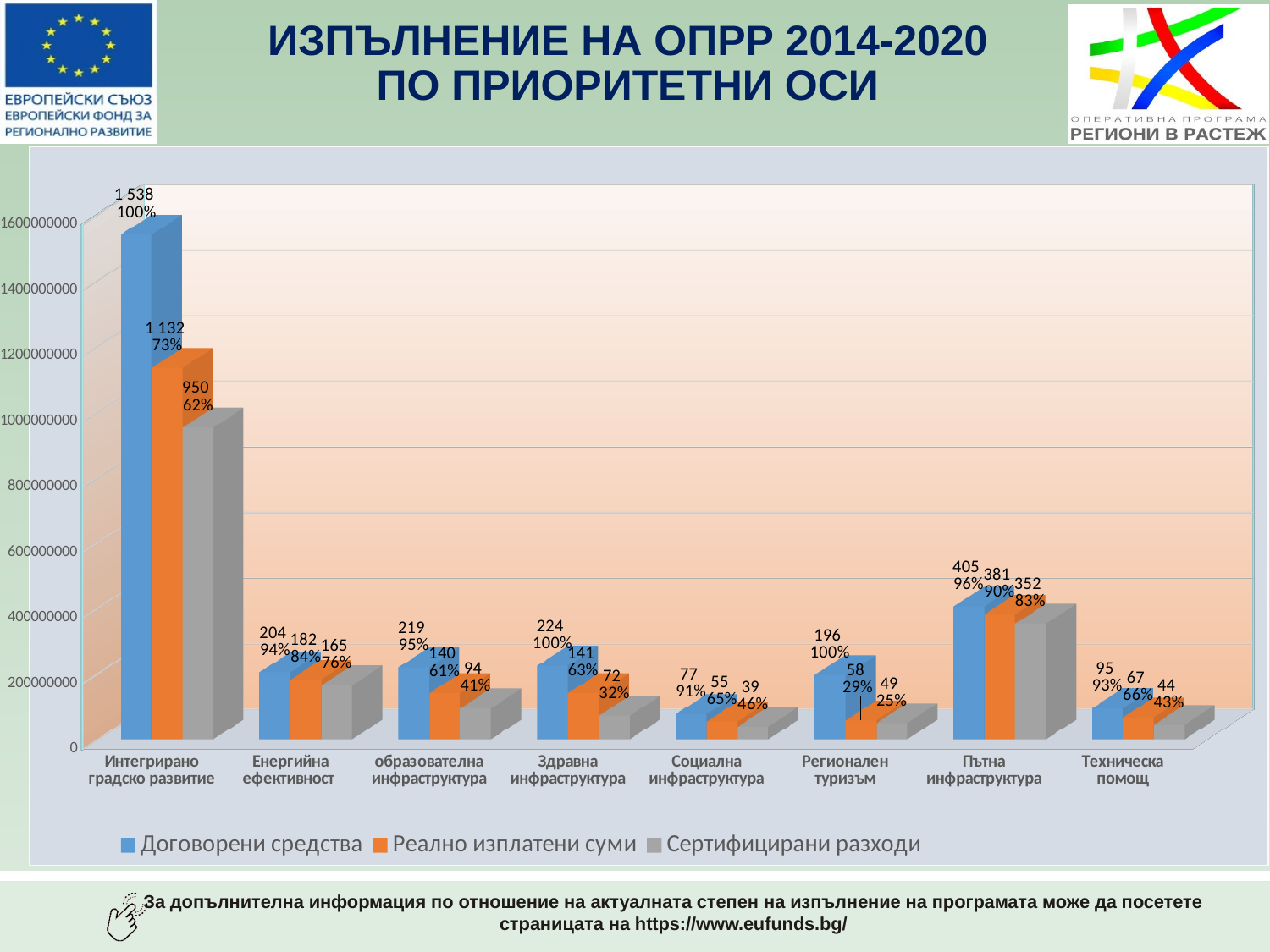
What is the difference between Договорени средства and Реално изплатени суми for Регионален туризъм? 138 What percentage is shown for Сертифицирани разходи for Здравна инфраструктура? 32% Which category has the highest value for Договорени средства? Интегрирано градско развитие Which category has the lowest value for Сертифицирани разходи? Социална инфраструктура How many priority axis categories are shown on the x axis? 8 What type of chart is shown on the slide? bar chart What is the data label value for Реално изплатени суми for Пътна инфраструктура? 381 Which is larger: Сертифицирани разходи for Енергийна ефективност or for Образователна инфраструктура? Енергийна ефективност How many series does the legend list? 3 Which series is shown in orange in the legend? Реално изплатени суми Is the Договорени средства bar for Пътна инфраструктура greater or less than 600000000? less What is the data label value for Договорени средства for Интегрирано градско развитие? 1 538